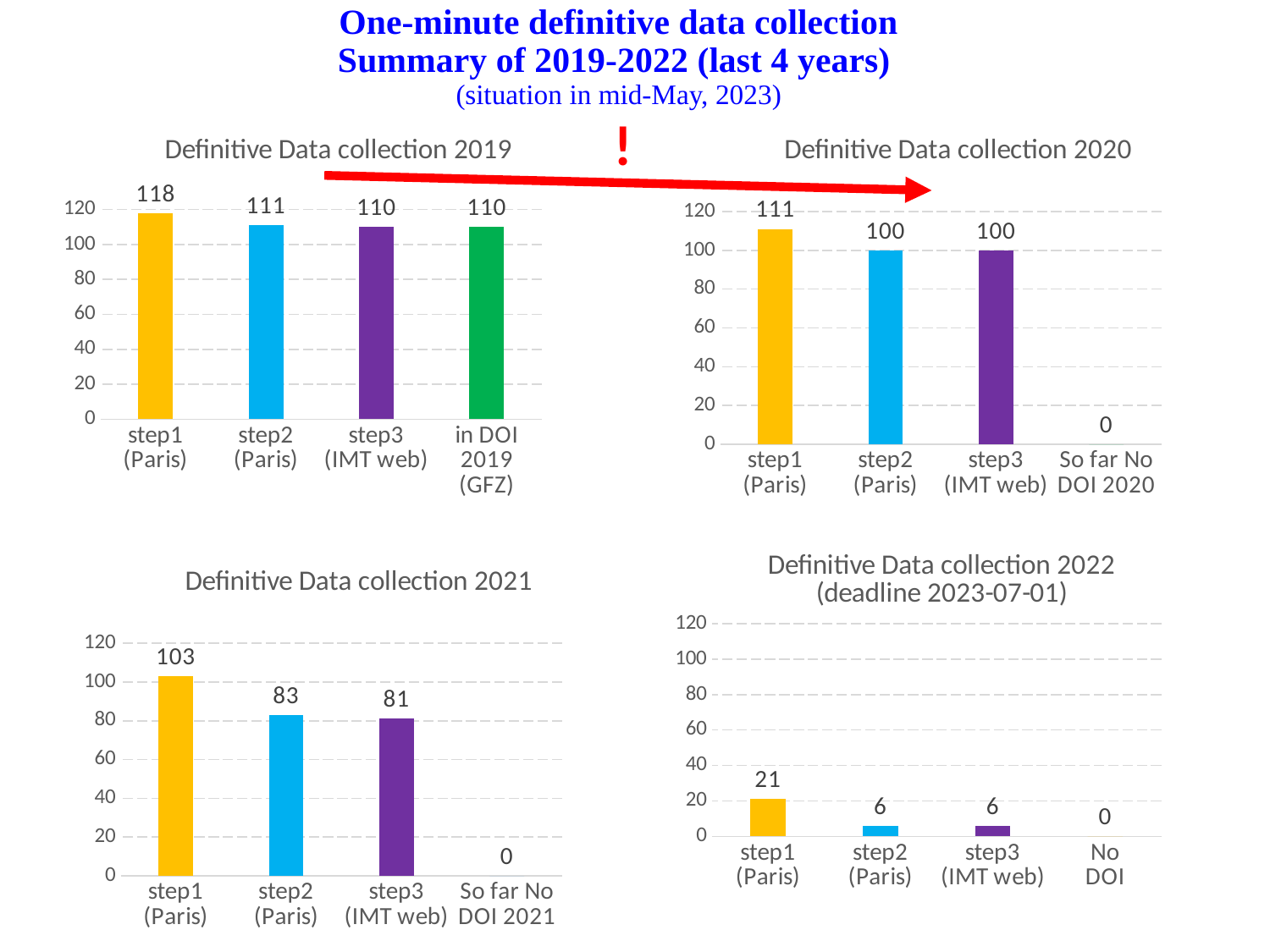
In the 'Definitive Data collection 2022' chart, which is larger, step1 (Paris) or step2 (Paris)? step1 (Paris) What kind of chart is the 'Definitive Data collection 2022' chart? bar chart In the 'Definitive Data collection 2019' chart, what is the value for in DOI 2019 (GFZ)? 110 In the 'Definitive Data collection 2019' chart, what is the value for step1 (Paris)? 118 In the 'Definitive Data collection 2020' chart, which category has the lowest value? So far No DOI 2020 In the 'Definitive Data collection 2021' chart, which category has the highest value? step1 (Paris) In the 'Definitive Data collection 2020' chart, what is the value for step3 (IMT web)? 100 In the 'Definitive Data collection 2022' chart, what is the value for step1 (Paris)? 21 In the 'Definitive Data collection 2019' chart, what is the difference between step1 (Paris) and step2 (Paris)? 7 In the 'Definitive Data collection 2021' chart, what is the value for step2 (Paris)? 83 How many categories does the 'Definitive Data collection 2019' chart show? 4 In the 'Definitive Data collection 2021' chart, what is the difference between step1 (Paris) and step3 (IMT web)? 22